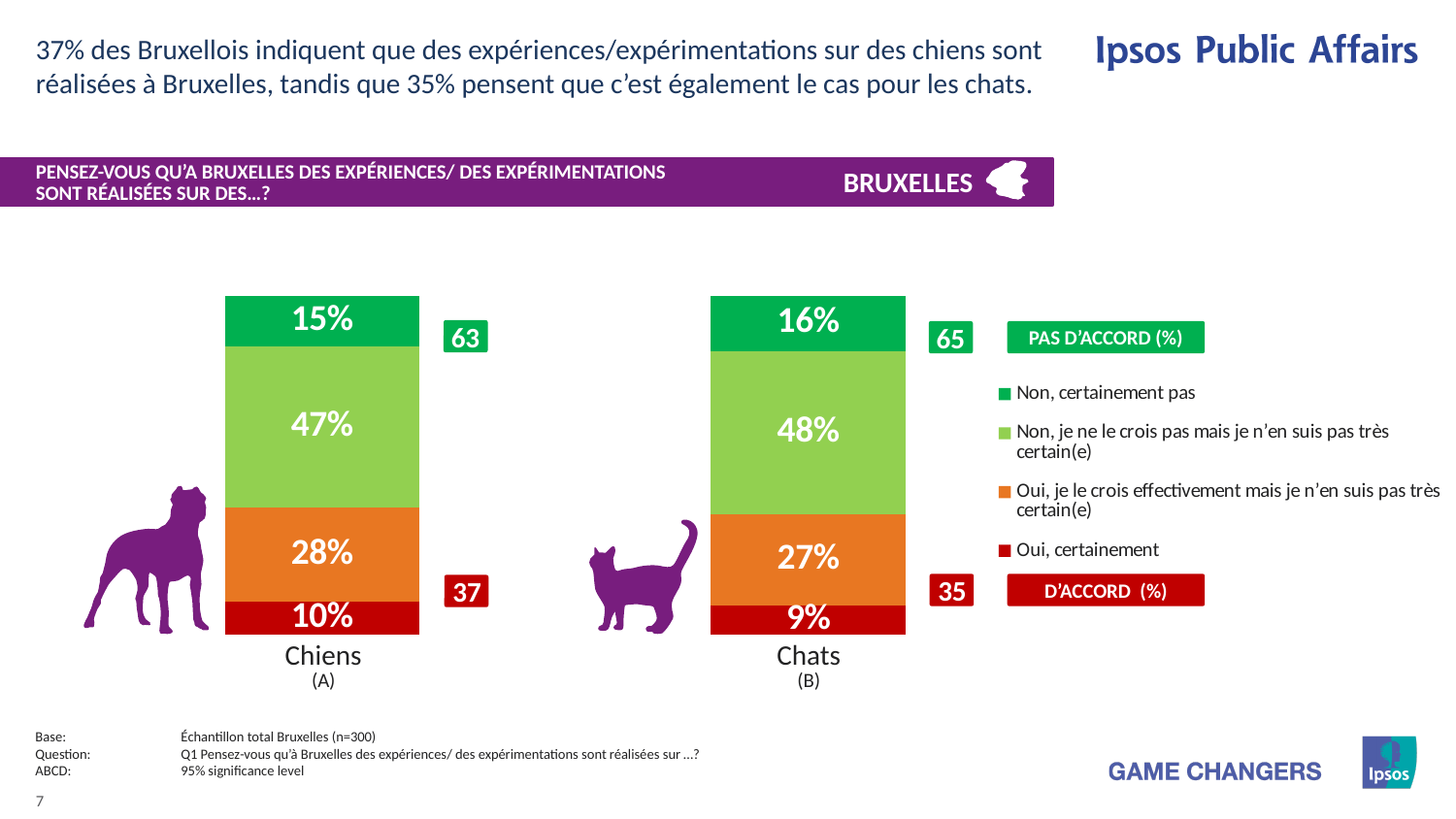
How many categories are shown on the x axis of the chart? 2 What is the value of the "Oui, je le crois effectivement mais je n'en suis pas très certain(e)" segment for Chiens? 28% How many series does the legend list? 4 Which segment is the largest in the Chiens bar? Non, je ne le crois pas mais je n'en suis pas très certain(e) What percentage of respondents answered "Non, je ne le crois pas mais je n'en suis pas très certain(e)" for Chats? 48% Which category has the higher "Oui, certainement" value, Chiens or Chats? Chiens Which segment is the smallest in the Chats bar? Oui, certainement What percentage of respondents answered "Oui, certainement" for Chiens? 10% What is the total "D'accord (%)" figure shown for Chiens? 37 What is the difference between the "Non, je ne le crois pas mais je n'en suis pas très certain(e)" values for Chats and Chiens? 1% What is the value of the "Non, certainement pas" segment for Chats? 16% What is the total "Pas d'accord (%)" figure shown for Chats? 65